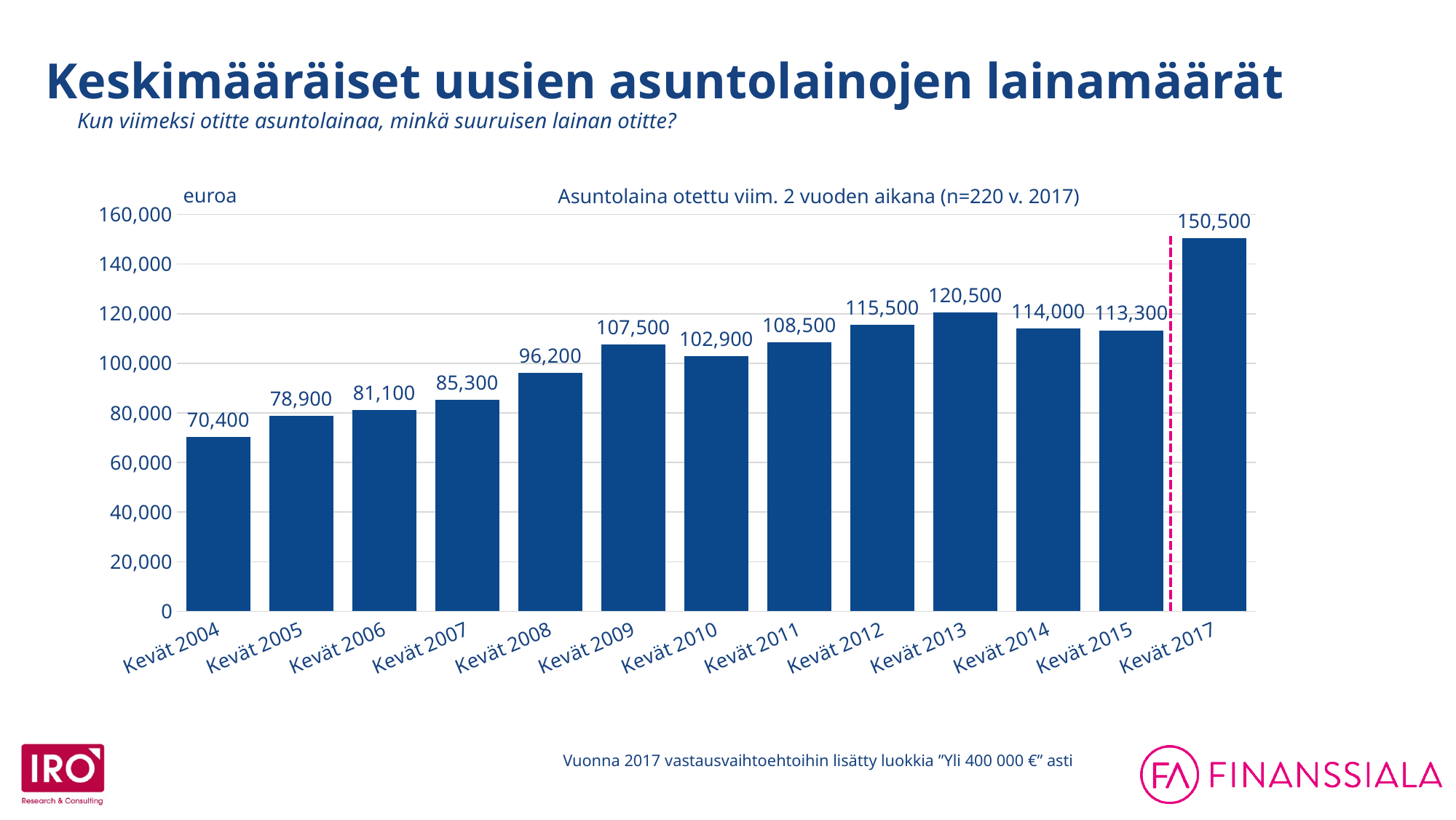
What unit label is shown at the top of the y axis? euroa Which category has the lowest value? Kevät 2004 What is the difference between the values for Kevät 2013 and Kevät 2012? 5,000 What is the value for Kevät 2010? 102,900 Which is larger, the value for Kevät 2009 or the value for Kevät 2010? Kevät 2009 What is the value for Kevät 2004? 70,400 Is the value for Kevät 2008 greater or less than 100,000? less What is the value for Kevät 2013? 120,500 How many categories are shown on the x axis? 13 What is the difference between the values for Kevät 2017 and Kevät 2015? 37,200 Which category has the highest value? Kevät 2017 What kind of chart is shown on the slide? bar chart